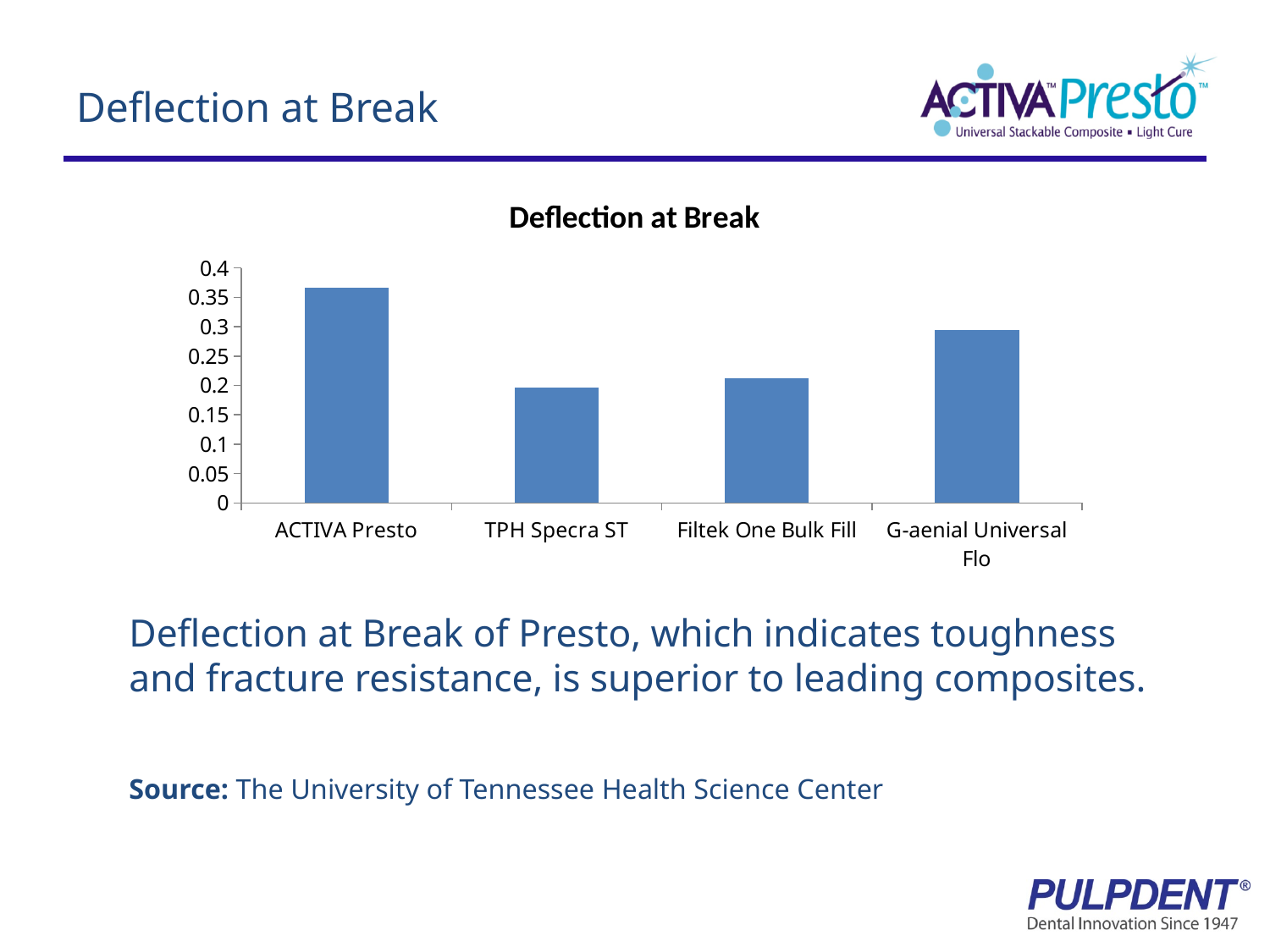
Is the value for Filtek One Bulk Fill greater or less than 0.15? greater Which is larger, the value for G-aenial Universal Flo or the value for TPH Specra ST? G-aenial Universal Flo What is the title of the chart? Deflection at Break Which is larger, the value for ACTIVA Presto or the value for G-aenial Universal Flo? ACTIVA Presto Which category has the highest deflection at break? ACTIVA Presto Is the value for TPH Specra ST greater or less than 0.25? less Is the value for G-aenial Universal Flo greater or less than 0.35? less How many categories are plotted in the chart? 4 What type of chart is shown on the slide? bar chart What colour are the bars in the chart? blue